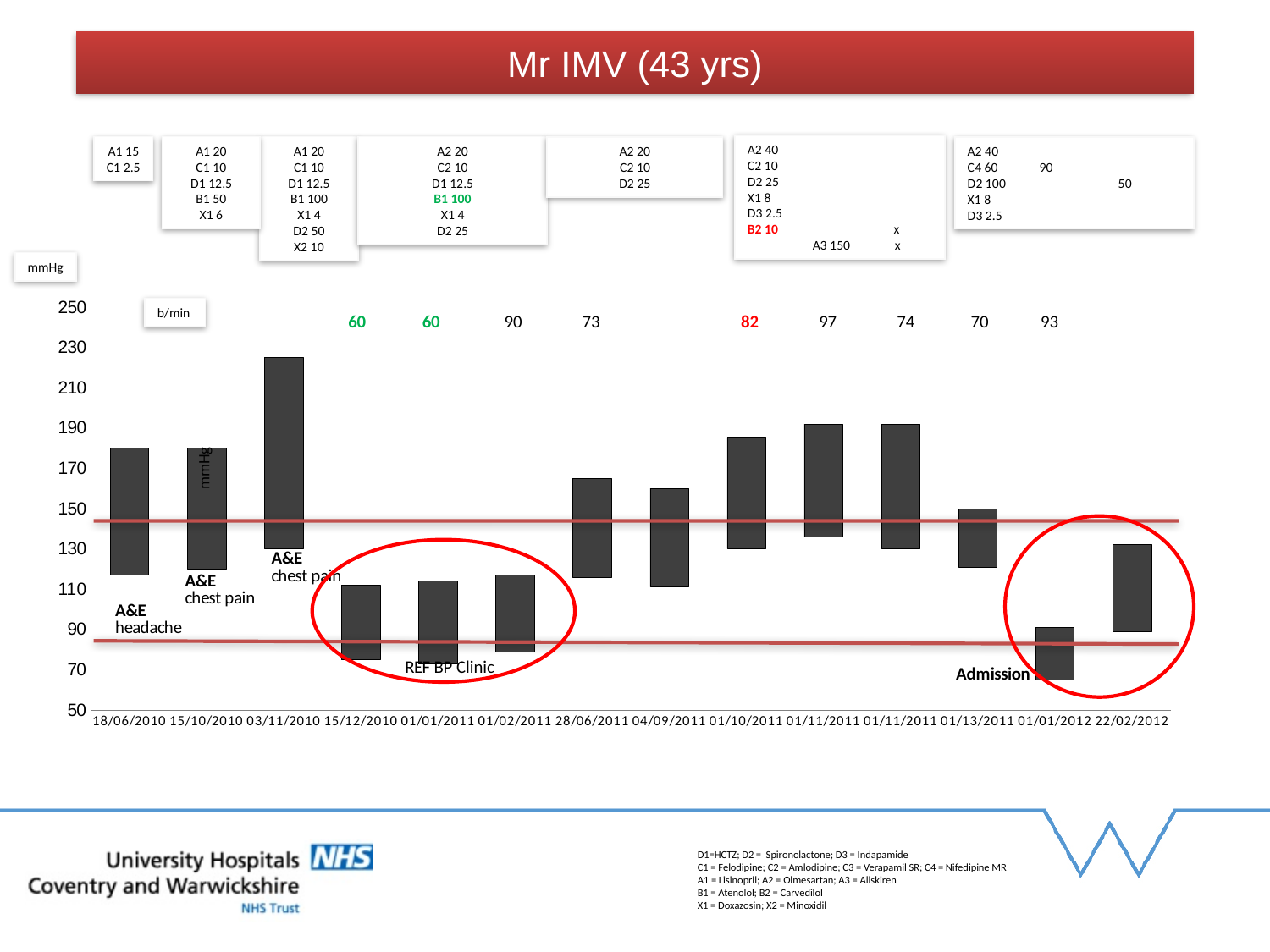
What is the title of the slide containing the chart? Mr IMV (43 yrs) Which date has the bar reaching the lowest value on the chart? 01/01/2012 Which bar reaches a higher value, 03/11/2010 or 18/06/2010? 03/11/2010 Is the top of the bar for 03/11/2010 greater or less than 210? greater What unit is shown for the y axis of the chart? mmHg Which bar reaches a higher value, 28/06/2011 or 15/12/2010? 28/06/2011 Is the top of the bar for 01/10/2011 greater or less than 170? greater What kind of chart is shown on the slide? bar chart Is the top of the bar for 01/01/2012 greater or less than 110? less Which date has the bar reaching the highest value on the chart? 03/11/2010 How many bars (dates) are plotted along the x axis of the chart? 14